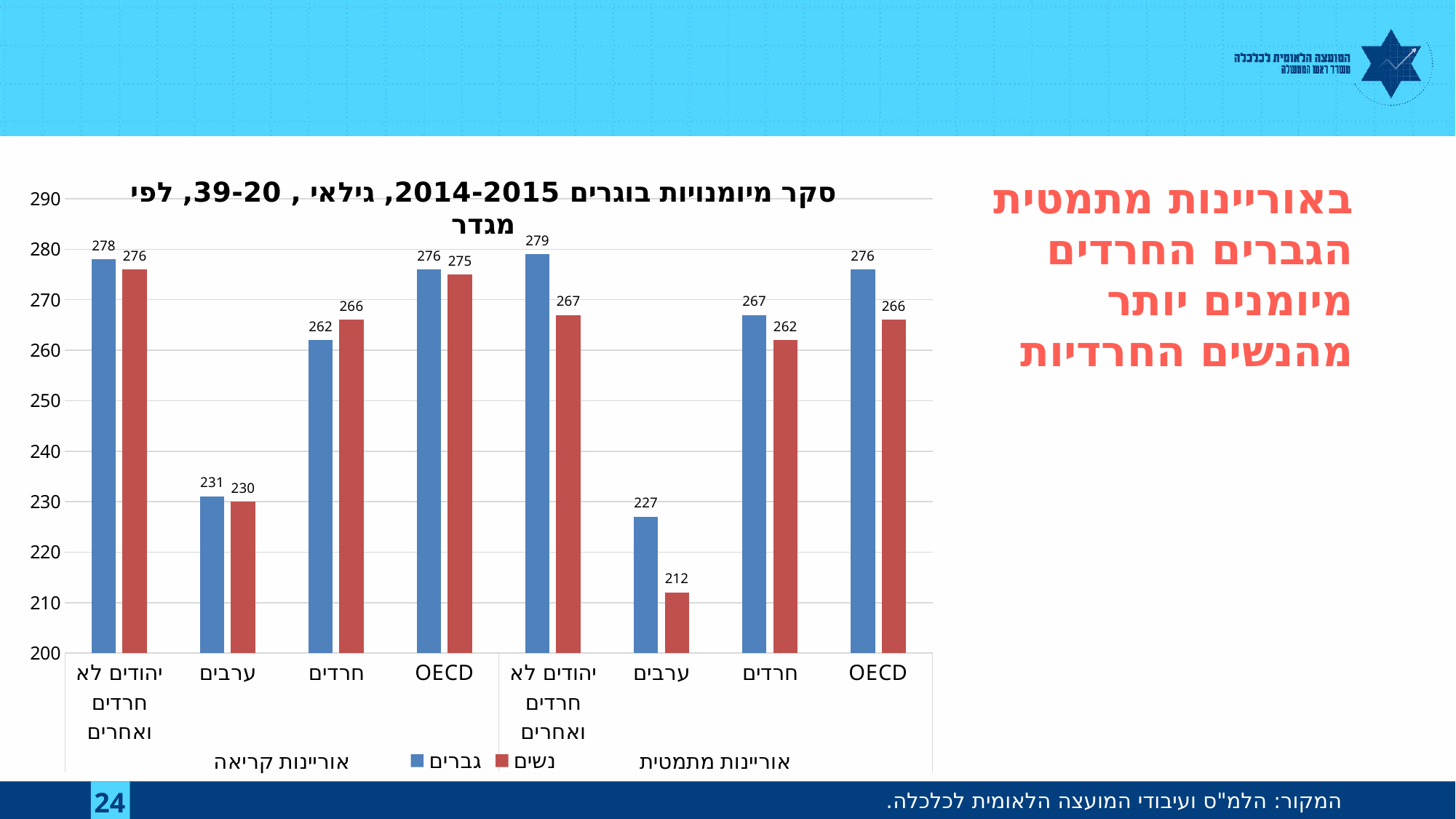
Which colour represents women (נשים) in the chart? red What is the value for men (גברים) in reading literacy (אוריינות קריאה) for חרדים? 262 In reading literacy (אוריינות קריאה) for חרדים, which is larger: the value for men (גברים) or for women (נשים)? נשים How many series does the legend list? 2 What is the difference between men (גברים) and women (נשים) in math literacy (אוריינות מתמטית) for חרדים? 5 What kind of chart is shown on the slide? bar chart Is the value for women (נשים) in math literacy (אוריינות מתמטית) for ערבים greater or less than 220? less Which category has the lowest value for women (נשים) across the whole chart? ערבים (אוריינות מתמטית) What is the difference between men (גברים) and women (נשים) in math literacy (אוריינות מתמטית) for יהודים לא חרדים ואחרים? 12 Which category has the highest value for men (גברים) across the whole chart? יהודים לא חרדים ואחרים (אוריינות מתמטית) What is the value for women (נשים) in reading literacy (אוריינות קריאה) for OECD? 275 What is the value for women (נשים) in math literacy (אוריינות מתמטית) for ערבים? 212